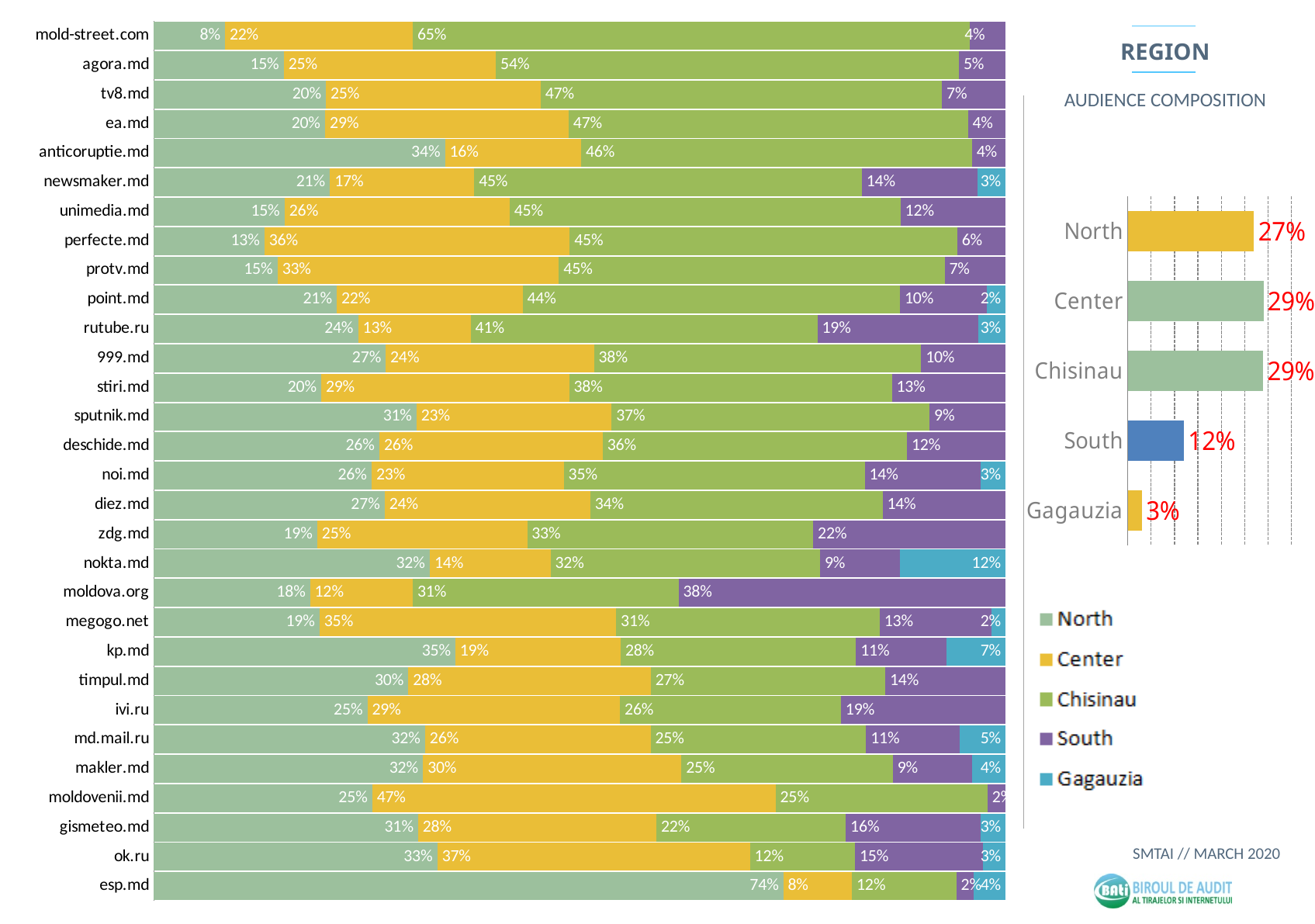
In the REGION audience composition chart on the right, which region has the lowest value? Gagauzia In the large stacked bar chart on the left, which has a larger Chisinau share, mold-street.com or agora.md? mold-street.com In the large stacked bar chart on the left, what is the Gagauzia share for nokta.md? 12% What kind of chart is the large chart on the left? Stacked bar chart In the large stacked bar chart on the left, what is the South share for moldova.org? 38% How many websites are listed in the large stacked bar chart on the left? 30 In the large stacked bar chart on the left, what is the difference between the Center share and the North share for ok.ru? 4 percentage points In the large stacked bar chart on the left, what is the North share for esp.md? 74% In the large stacked bar chart on the left, what is the Chisinau share for mold-street.com? 65% In the REGION audience composition chart on the right, what is the value for North? 27% How many series does the legend of the large stacked bar chart list? 5 In the REGION audience composition chart on the right, what is the difference between North and South? 15 percentage points